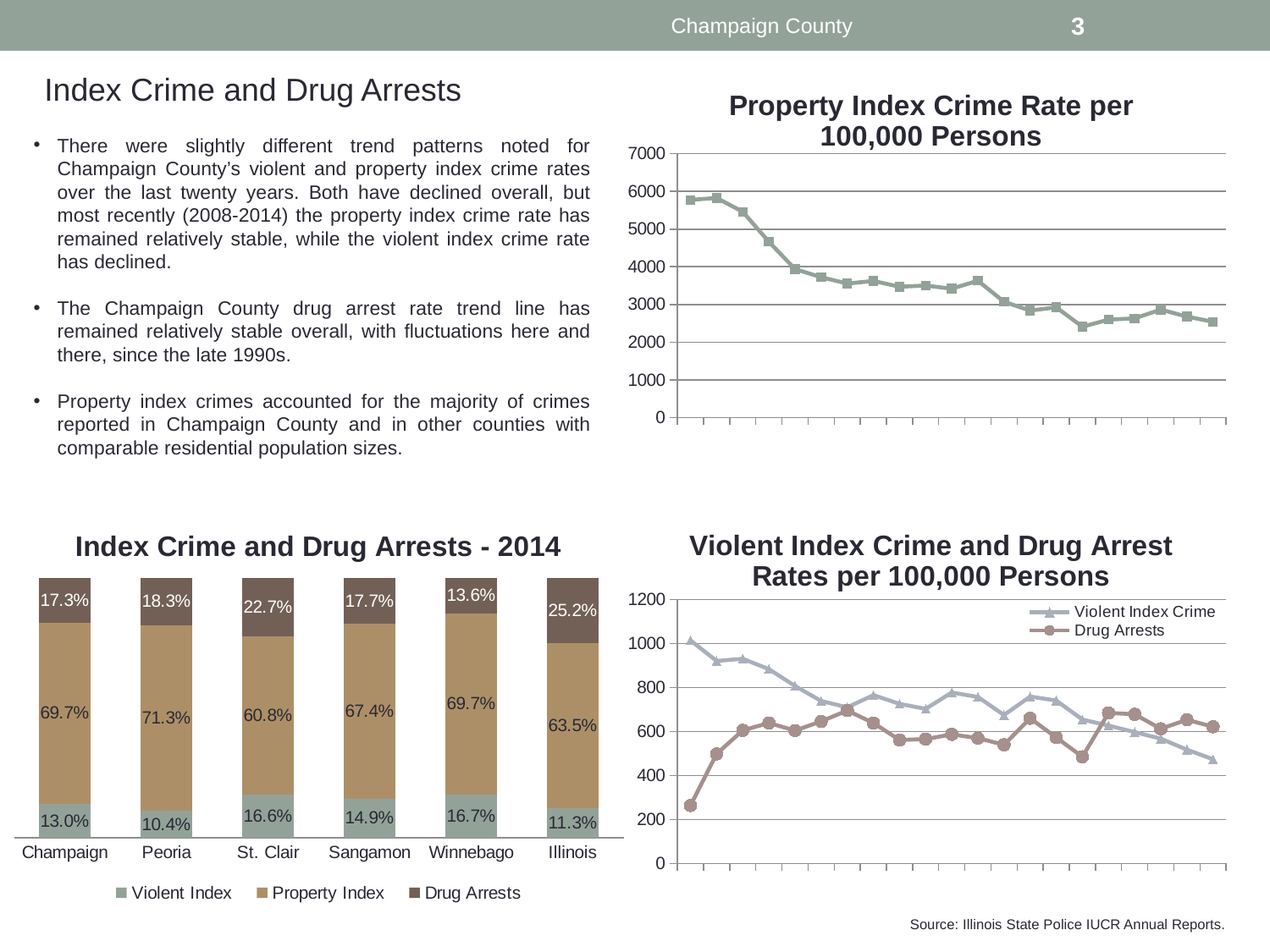
What kind of chart is 'Index Crime and Drug Arrests - 2014'? Stacked bar chart In the 'Index Crime and Drug Arrests - 2014' chart, which category has the lowest Drug Arrests share? Winnebago In the 'Index Crime and Drug Arrests - 2014' chart, what is the Property Index share for Peoria? 71.3% In the 'Index Crime and Drug Arrests - 2014' chart, what is the Drug Arrests share for Illinois? 25.2% In the 'Index Crime and Drug Arrests - 2014' chart, which category has the highest Property Index share? Peoria In the 'Violent Index Crime and Drug Arrest Rates per 100,000 Persons' chart, is the first Drug Arrests point greater or less than 400? less In the 'Property Index Crime Rate per 100,000 Persons' chart, do the values generally rise or fall from left to right? Fall In the 'Index Crime and Drug Arrests - 2014' chart, how much larger is the Drug Arrests share than the Violent Index share for Champaign? 4.3 percentage points In the 'Property Index Crime Rate per 100,000 Persons' chart, is the first point greater or less than 5000? greater How many series does the legend of the 'Index Crime and Drug Arrests - 2014' chart list? 3 In the 'Index Crime and Drug Arrests - 2014' chart, which has the larger Property Index share, St. Clair or Sangamon? Sangamon How many categories are shown on the x axis of the 'Index Crime and Drug Arrests - 2014' chart? 6